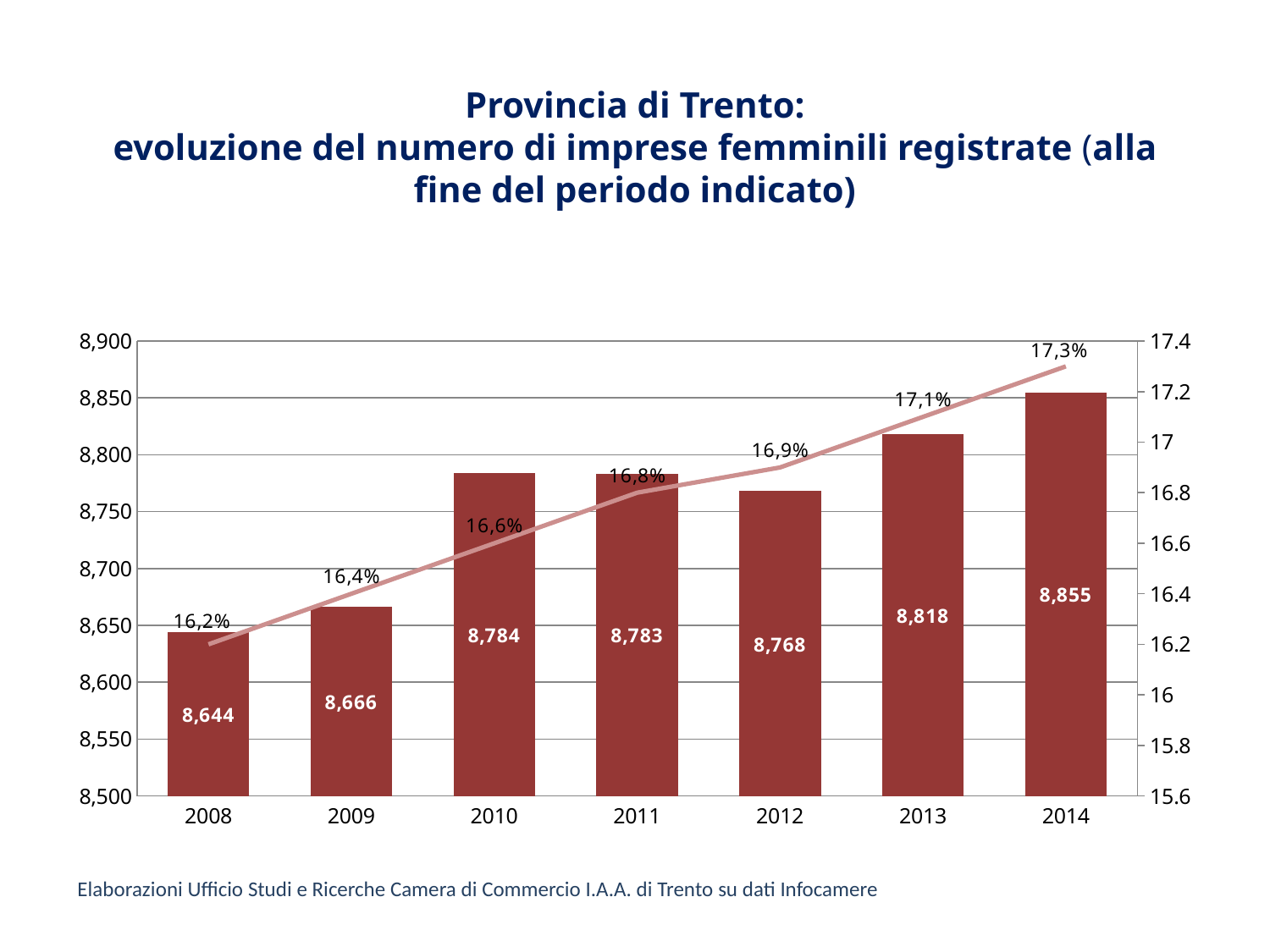
What is the number of registered women-led enterprises shown for 2014? 8,855 What is the difference between the bar values for 2014 and 2008? 211 Which year has the highest bar value? 2014 How many years are shown on the x axis? 7 Does the percentage line rise or fall from 2008 to 2014? Rises What value does the bar for 2008 show? 8,644 What percentage does the line show for 2012? 16,9% What percentage does the line show for 2010? 16,6% Which is larger, the bar value for 2010 or for 2011? 2010 What is the difference between the percentage values for 2014 and 2013? 0,2% Which year has the lowest bar value? 2008 What kind of chart is shown on the slide? Combined bar and line chart